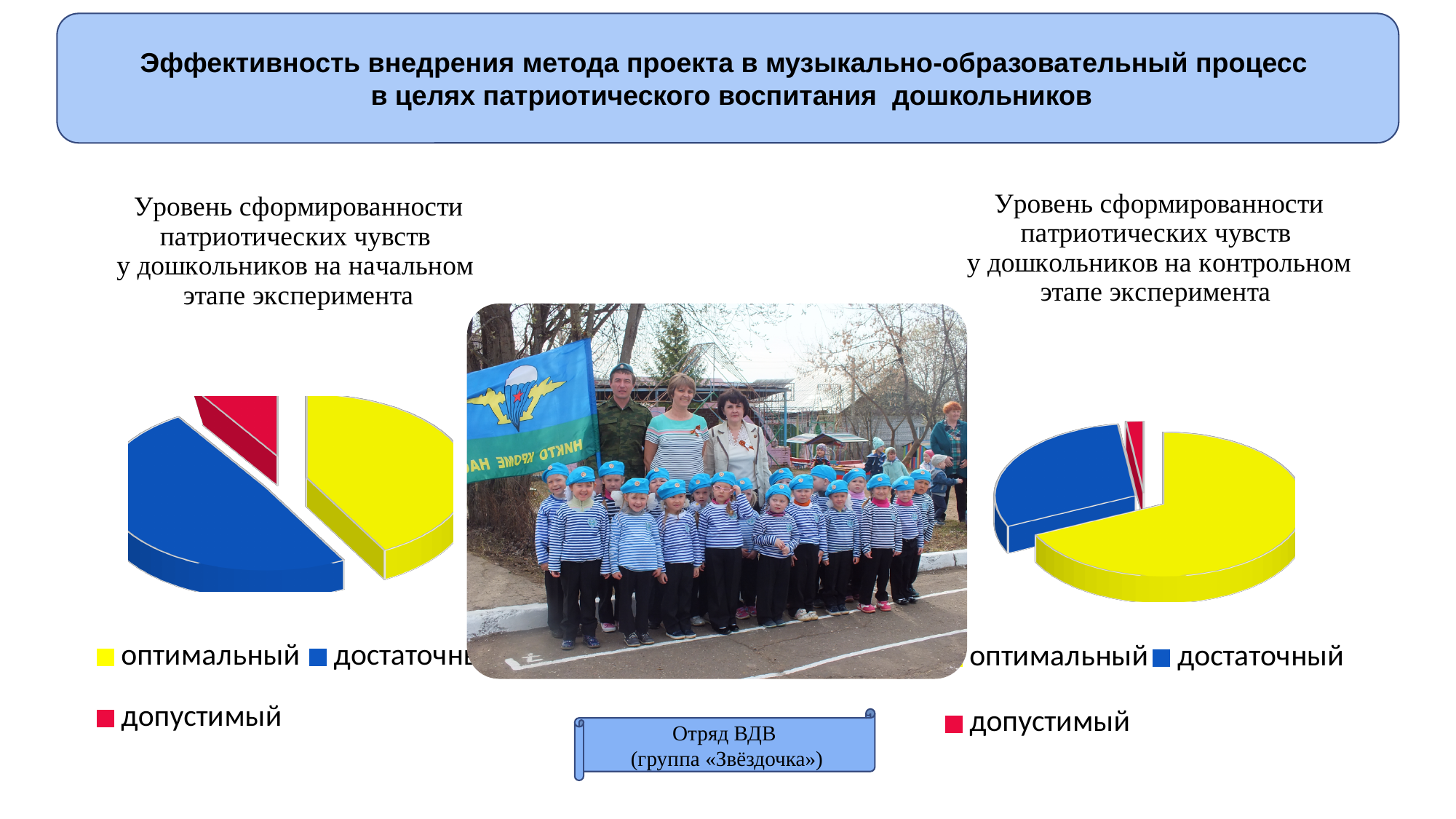
In the right pie chart (контрольный этап эксперимента), which category has the smallest slice? допустимый In the right pie chart (контрольный этап эксперимента), which slice is larger: оптимальный or достаточный? оптимальный What colour represents the category 'оптимальный' in the pie charts? Yellow What colour represents the category 'допустимый' in the pie charts? Red How many categories does the legend of the right pie chart list? 3 In the left pie chart (начальный этап эксперимента), which category has the largest slice? достаточный In the right pie chart (контрольный этап эксперимента), which category has the largest slice? оптимальный In the left pie chart (начальный этап эксперимента), which slice is larger: оптимальный or достаточный? достаточный How many categories does the legend of the left pie chart list? 3 What kind of chart is the left chart, titled 'Уровень сформированности патриотических чувств у дошкольников на начальном этапе эксперимента'? Pie chart In the left pie chart (начальный этап эксперимента), which category has the smallest slice? допустимый What kind of chart is the right chart, titled 'Уровень сформированности патриотических чувств у дошкольников на контрольном этапе эксперимента'? Pie chart